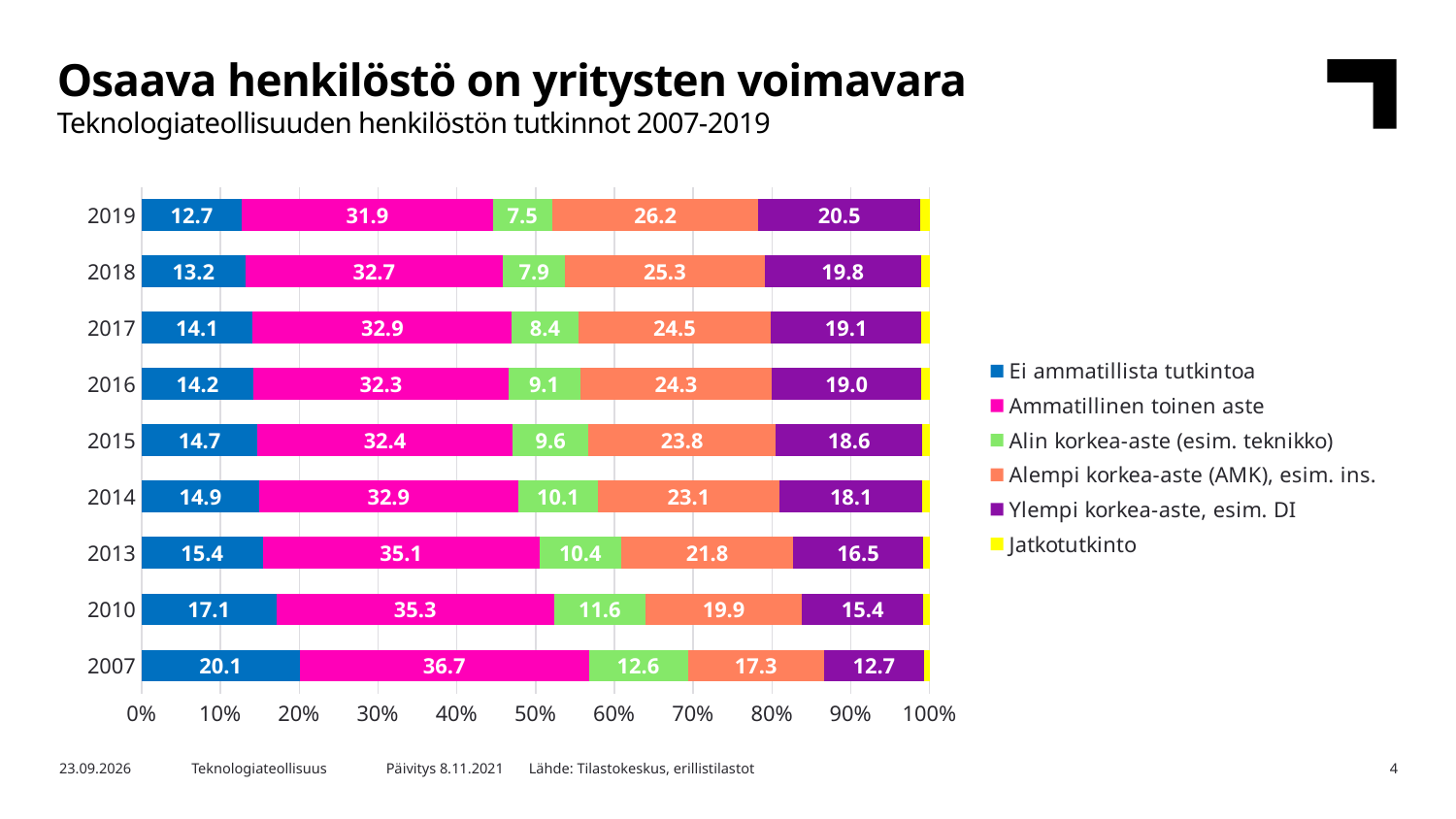
Which series is shown in yellow in the legend? Jatkotutkinto How many series does the legend list? 6 Does the value for 'Ylempi korkea-aste, esim. DI' rise or fall from 2007 to 2019? Rise What is the value for 'Ylempi korkea-aste, esim. DI' in 2016? 19.0 What is the value for 'Ammatillinen toinen aste' in 2007? 36.7 Which is larger in 2014: 'Ammatillinen toinen aste' or 'Alempi korkea-aste (AMK), esim. ins.'? Ammatillinen toinen aste Which year has the lowest value for 'Alin korkea-aste (esim. teknikko)'? 2019 What kind of chart is shown on the slide? Stacked bar chart What is the value for 'Ei ammatillista tutkintoa' in 2019? 12.7 Which year has the highest value for 'Ei ammatillista tutkintoa'? 2007 What is the difference between the 'Alempi korkea-aste (AMK), esim. ins.' values for 2019 and 2007? 8.9 How many years (bars) are shown in the chart? 9